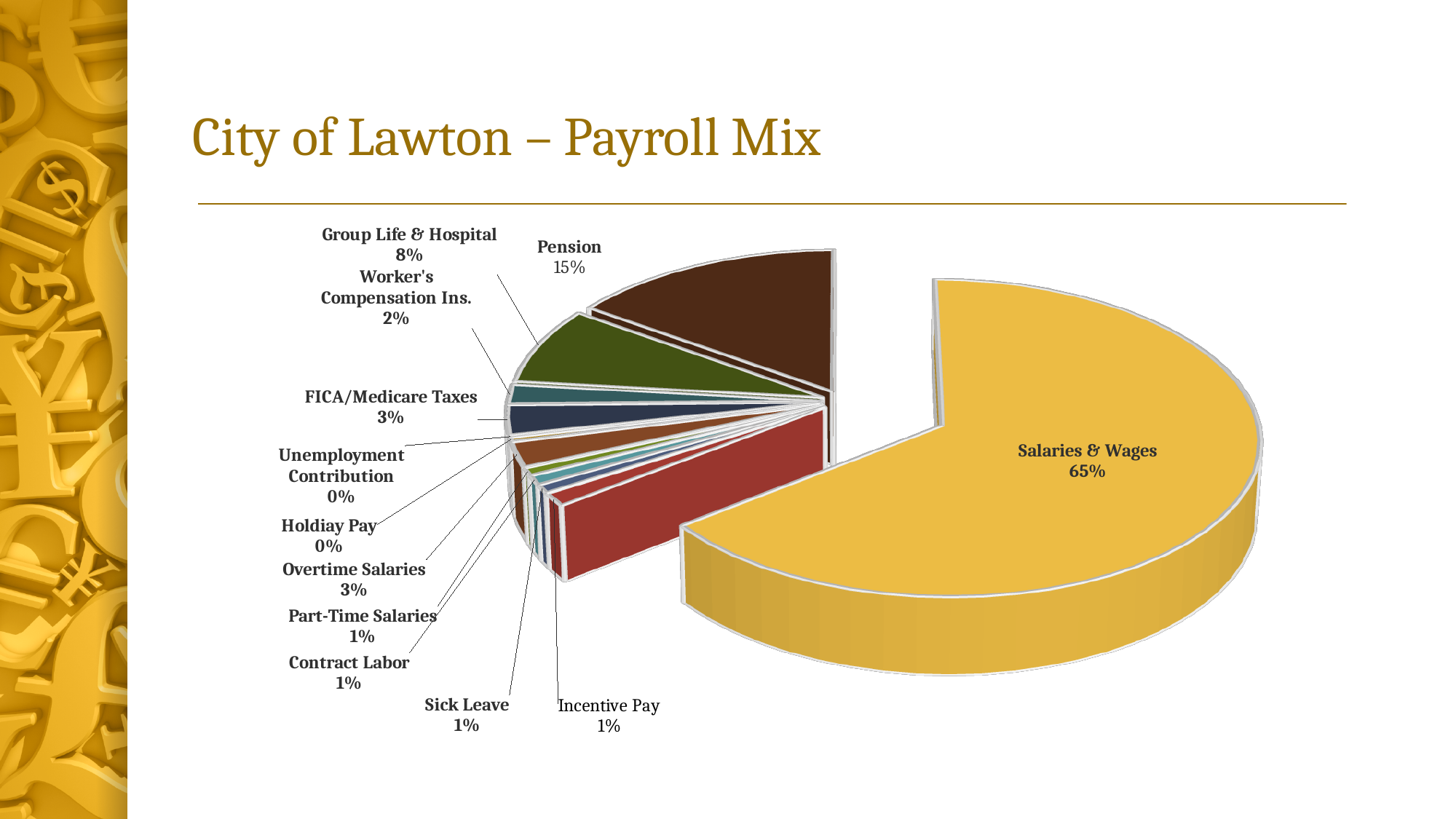
What percentage is shown for Worker's Compensation Ins.? 2% What percentage is shown for Group Life & Hospital? 8% What kind of chart is shown on the slide? Pie chart What is the difference in percentage points between Salaries & Wages and Pension? 50 What is the title of the slide? City of Lawton – Payroll Mix What percentage of the payroll mix is Pension? 15% How many categories are shown in the pie chart? 12 Which category has the largest share of the payroll mix? Salaries & Wages What percentage is shown for FICA/Medicare Taxes? 3% Which is larger, the share for Group Life & Hospital or the share for Overtime Salaries? Group Life & Hospital What percentage is shown for Sick Leave? 1% What share of the payroll mix is Salaries & Wages? 65%